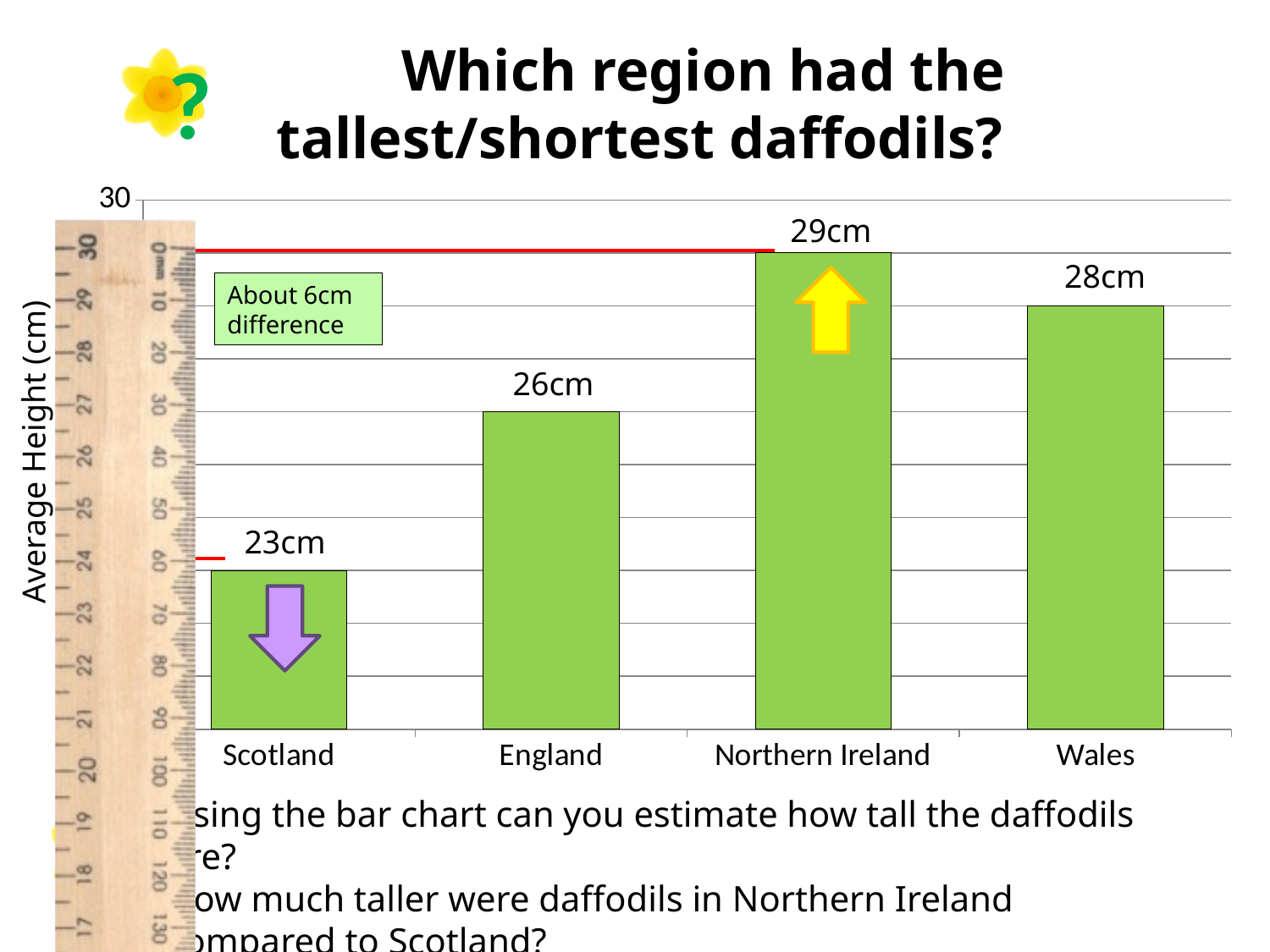
What is the difference between the values for Wales and England? 2cm How many regions are shown in the bar chart? 4 What is the average daffodil height shown for Wales? 28cm What is the average daffodil height shown for Scotland? 23cm What is the average daffodil height shown for Northern Ireland? 29cm What is the average daffodil height shown for England? 26cm Which region has the shortest daffodils in the chart? Scotland Which has the larger value, England or Wales? Wales How much taller are the daffodils in Northern Ireland than in Scotland? 6cm What is the label on the vertical axis of the chart? Average Height (cm) Which region has the tallest daffodils in the chart? Northern Ireland What type of chart is shown on the slide? Bar chart